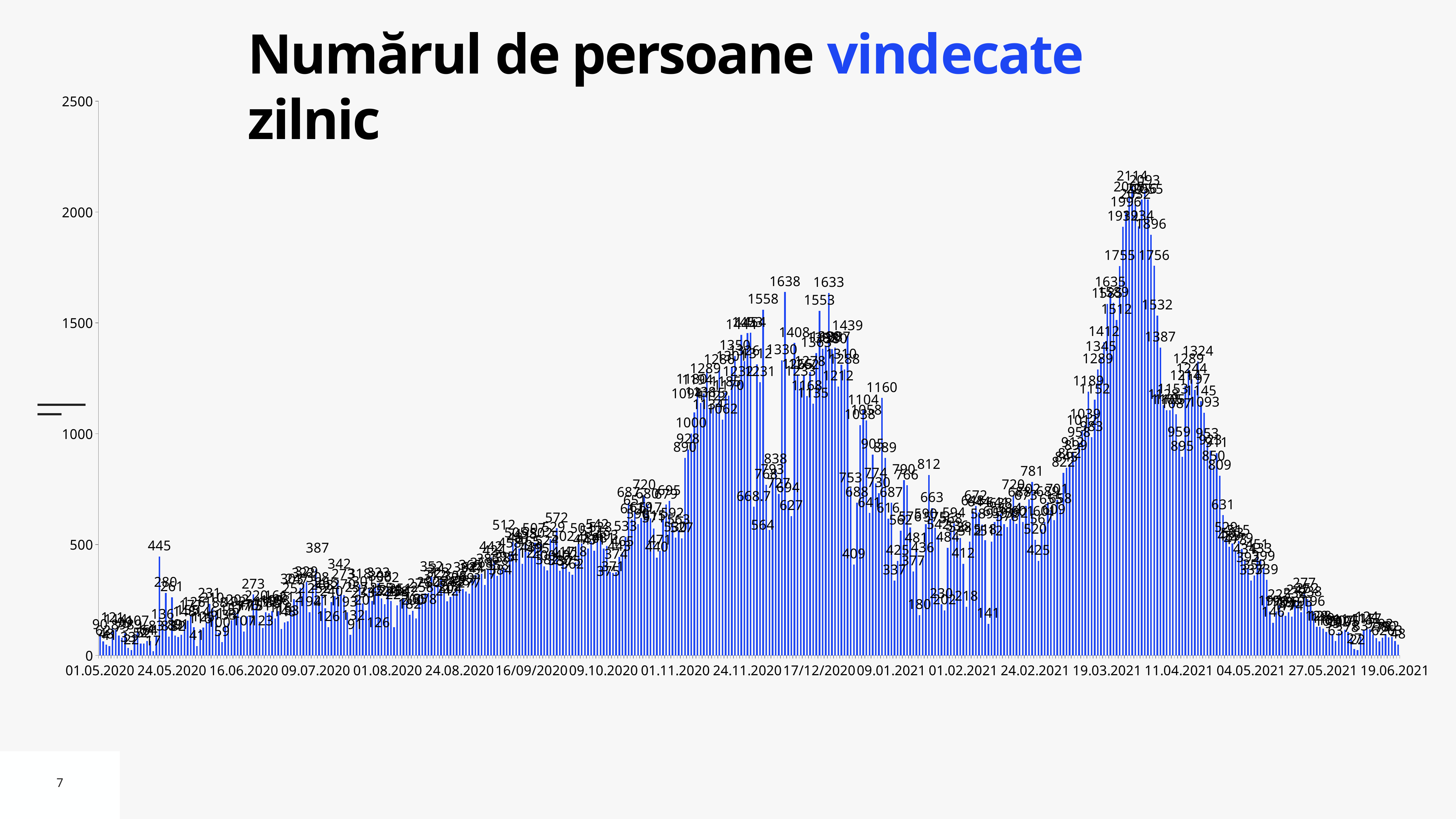
What is the title of the chart? Numărul de persoane vindecate zilnic What kind of chart is shown on the slide? bar chart What is the value of the tallest bar in the peak between 01.11.2020 and 17/12/2020? 1638 Is the value of the tallest bar in May 2020 greater or less than 500? less Which is larger: the peak value in April 2021 or the peak value in late November 2020? April 2021 What is the highest value shown on the y axis? 2500 Is the highest value on the chart greater or less than 2000? greater What is the highest value labeled on the chart? 2114 What is the value of the tallest bar in May 2020, near the 24.05.2020 label? 445 Do the values generally rise or fall between 11.04.2021 and 19.06.2021? fall What is the difference between the overall peak value (2114) and the late-November 2020 peak value (1638)? 476